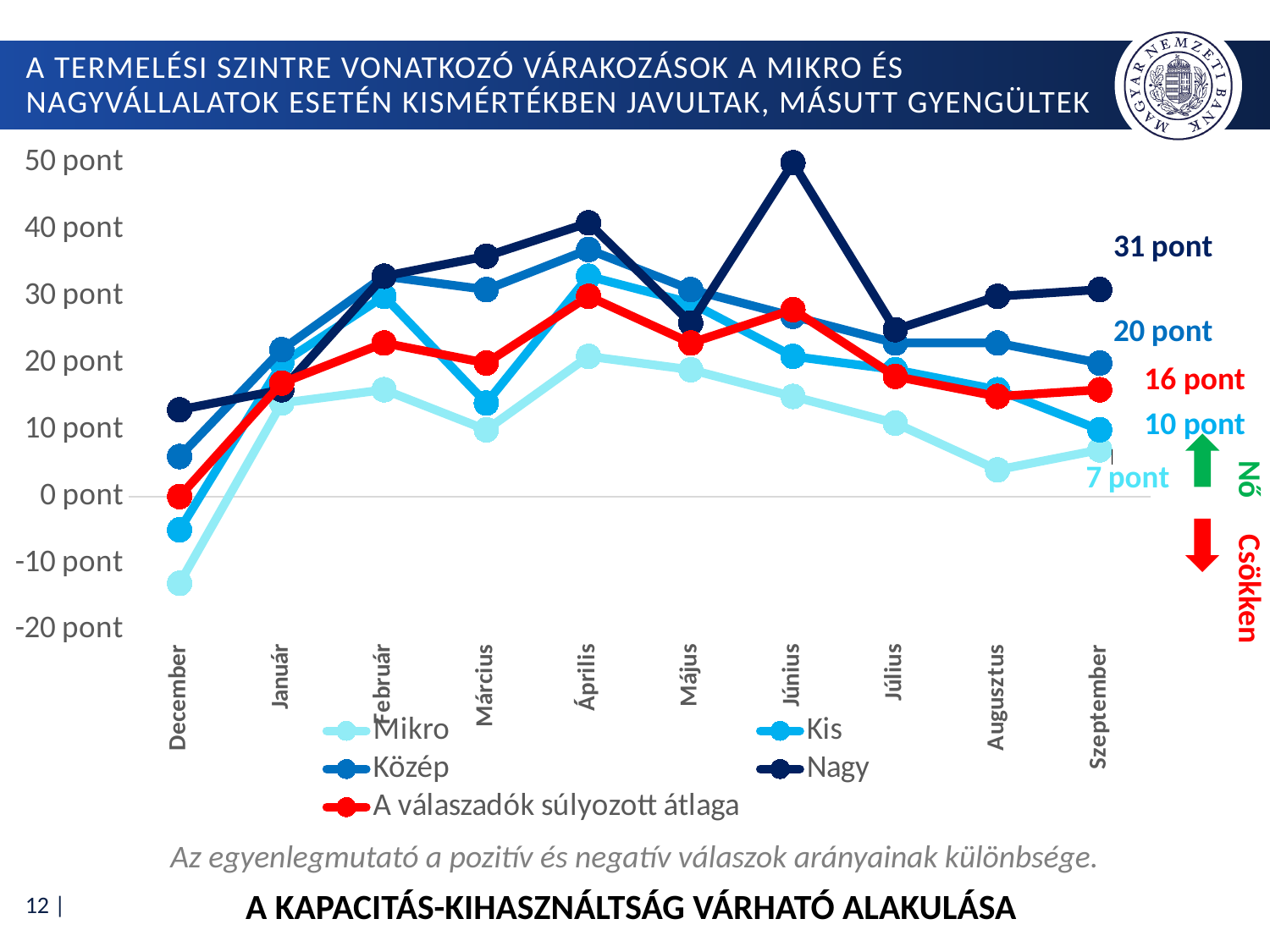
What kind of chart is shown on the slide? line chart What is the value of the Közép series in Szeptember? 20 pont What is the value of the Mikro series in Szeptember? 7 pont In Szeptember, how much higher is the Nagy series than the Mikro series? 24 pont How many months are shown along the x axis? 10 What is the value of the Kis series in Szeptember? 10 pont What is the value of 'A válaszadók súlyozott átlaga' in Szeptember? 16 pont Is the value for the Nagy series in Június greater or less than 40 pont? greater What is the value of the Nagy series in Szeptember? 31 pont Is the value for the Mikro series in December greater or less than 0 pont? less How many series does the legend list? 5 Which series has the highest value in Szeptember? Nagy